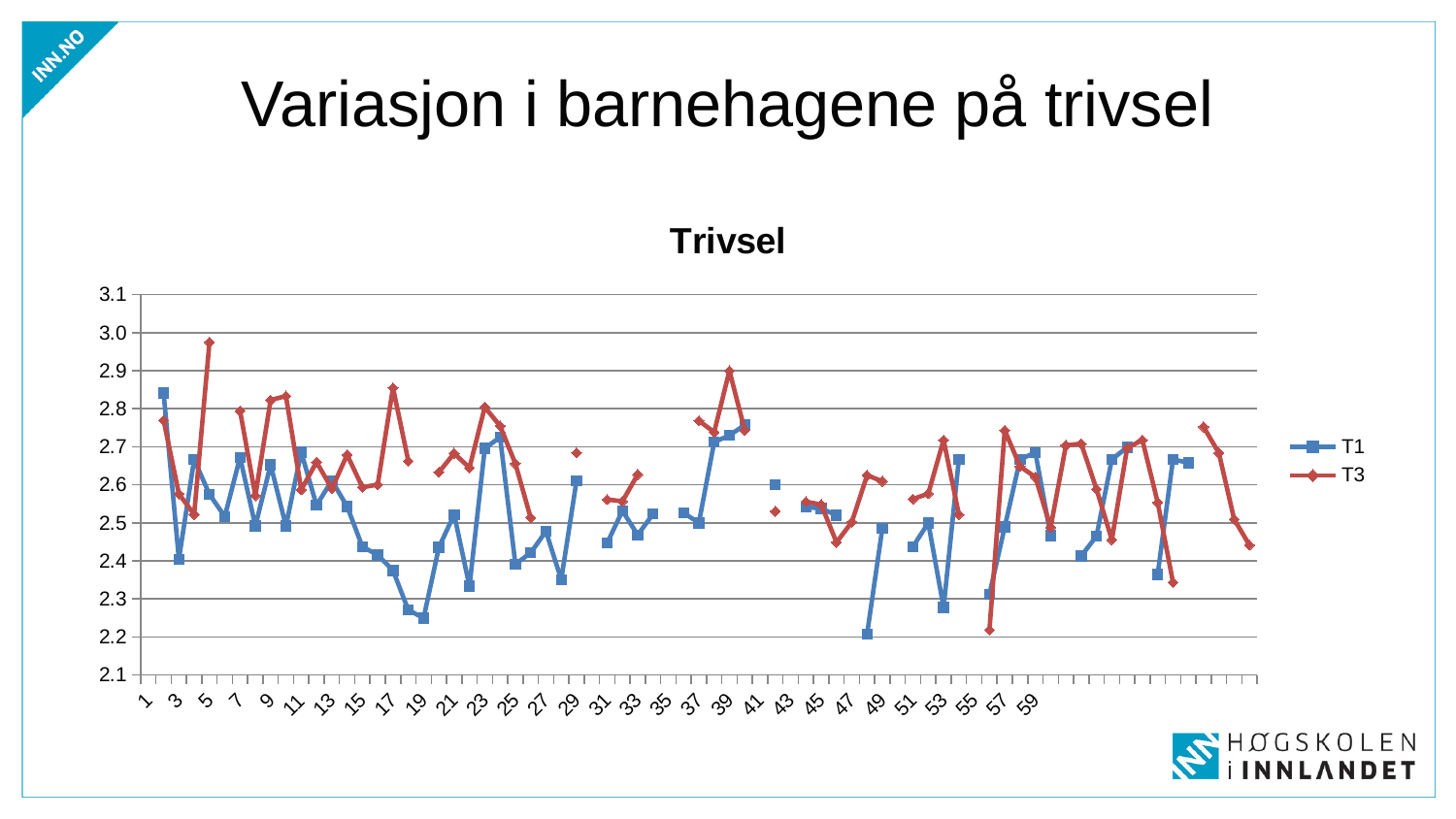
How many series does the legend list? 2 Which series reaches the highest value anywhere on the chart? T3 Is the value of T1 at x = 49 greater or less than 2.3? greater Is the value of T1 at x = 19 greater or less than 2.3? less What kind of chart is shown on the slide? line chart Which series is drawn in red? T3 Is the value of T1 at x = 3 greater or less than 2.5? less What is the title of the chart? Trivsel At x = 5, which series has the larger value, T1 or T3? T3